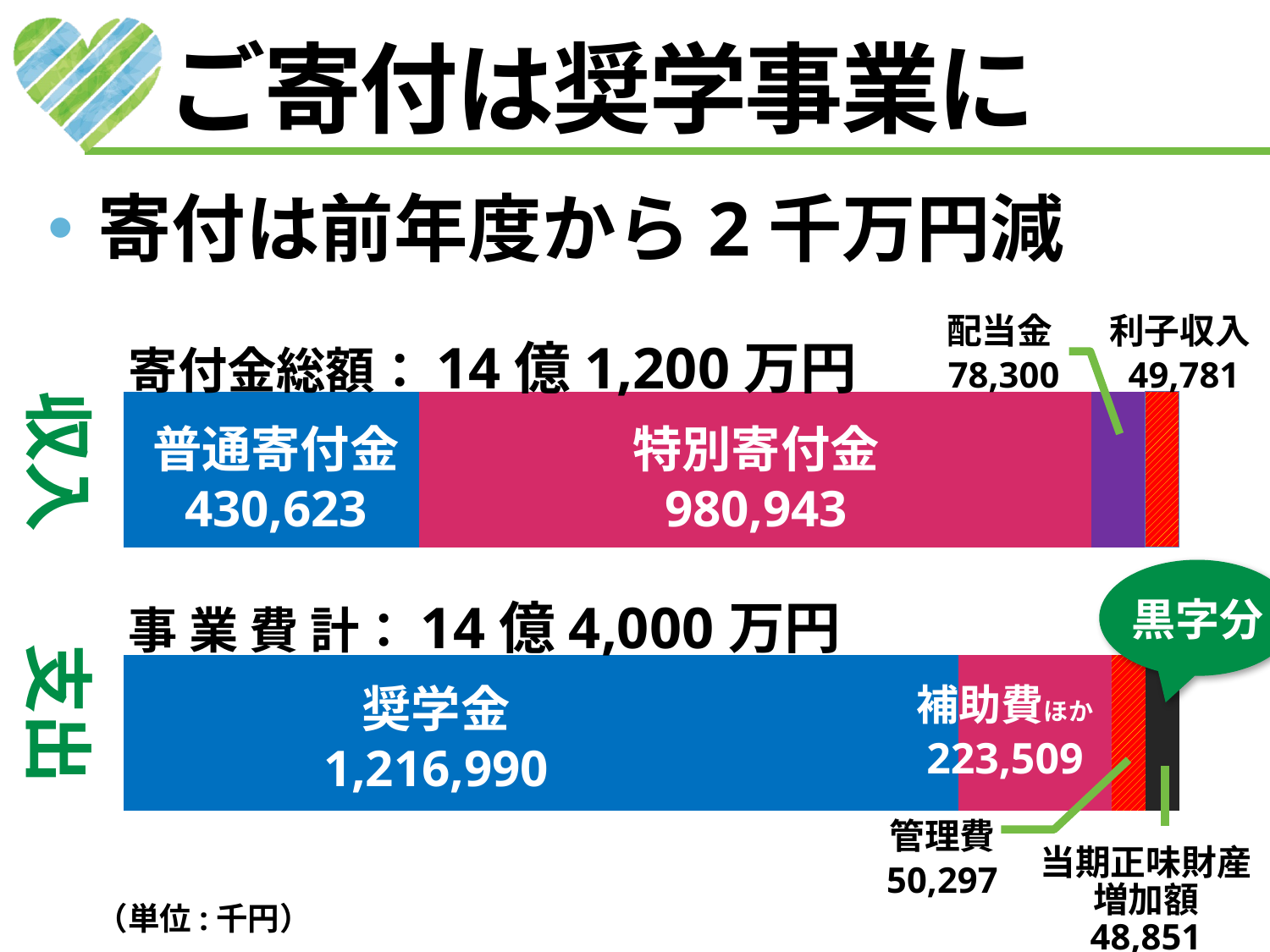
What kind of chart is shown on the slide? Stacked bar chart In the 収入 bar, what is the difference between 特別寄付金 and 普通寄付金? 550,320 In the 支出 bar, what is the value for 奨学金? 1,216,990 In the 支出 bar, which segment is the smallest? 当期正味財産増加額 In the 収入 bar, which segment is the smallest? 利子収入 In the 収入 bar, what is the value for 特別寄付金? 980,943 What is the total of the 収入 bar? 1,539,647 In the 収入 bar, which segment is the largest? 特別寄付金 In the 支出 bar, what is the value for 管理費? 50,297 In the 収入 bar, what is the value for 普通寄付金? 430,623 In the 収入 bar, which is larger, 配当金 or 利子収入? 配当金 How many segments make up the 支出 bar? 4